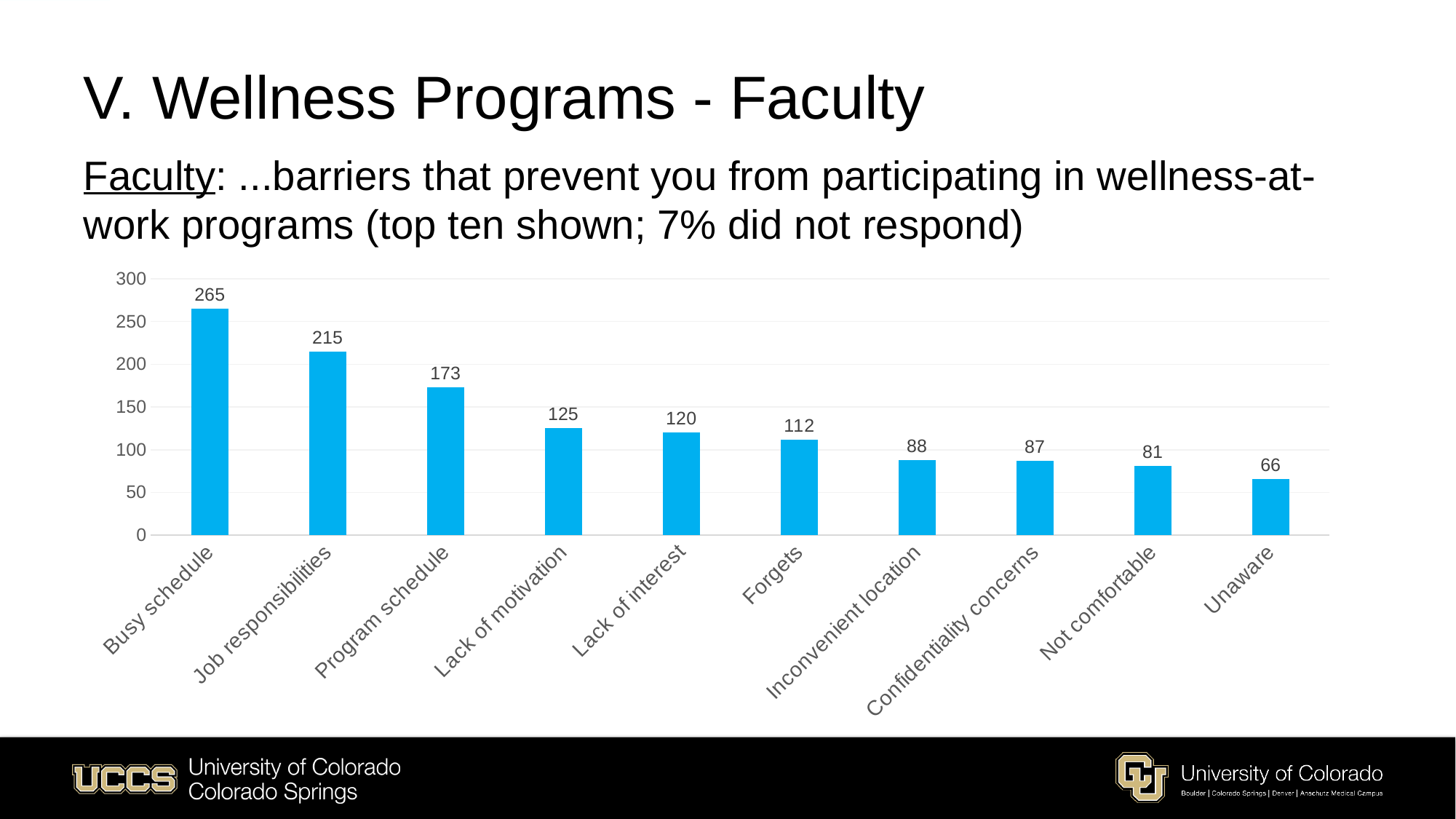
What is the difference between the values for Lack of motivation and Unaware? 59 What is the value for Program schedule? 173 Which barrier has the lowest value? Unaware Do the values rise or fall from left to right along the x axis? Fall What is the difference between the values for Busy schedule and Job responsibilities? 50 How many barriers are shown in the chart? 10 Which barrier has the highest value? Busy schedule Which is larger, the value for Forgets or the value for Not comfortable? Forgets Is the value for Lack of interest greater or less than 100? greater What is the value for Busy schedule? 265 What is the value for Confidentiality concerns? 87 What kind of chart is shown on the slide? Bar chart